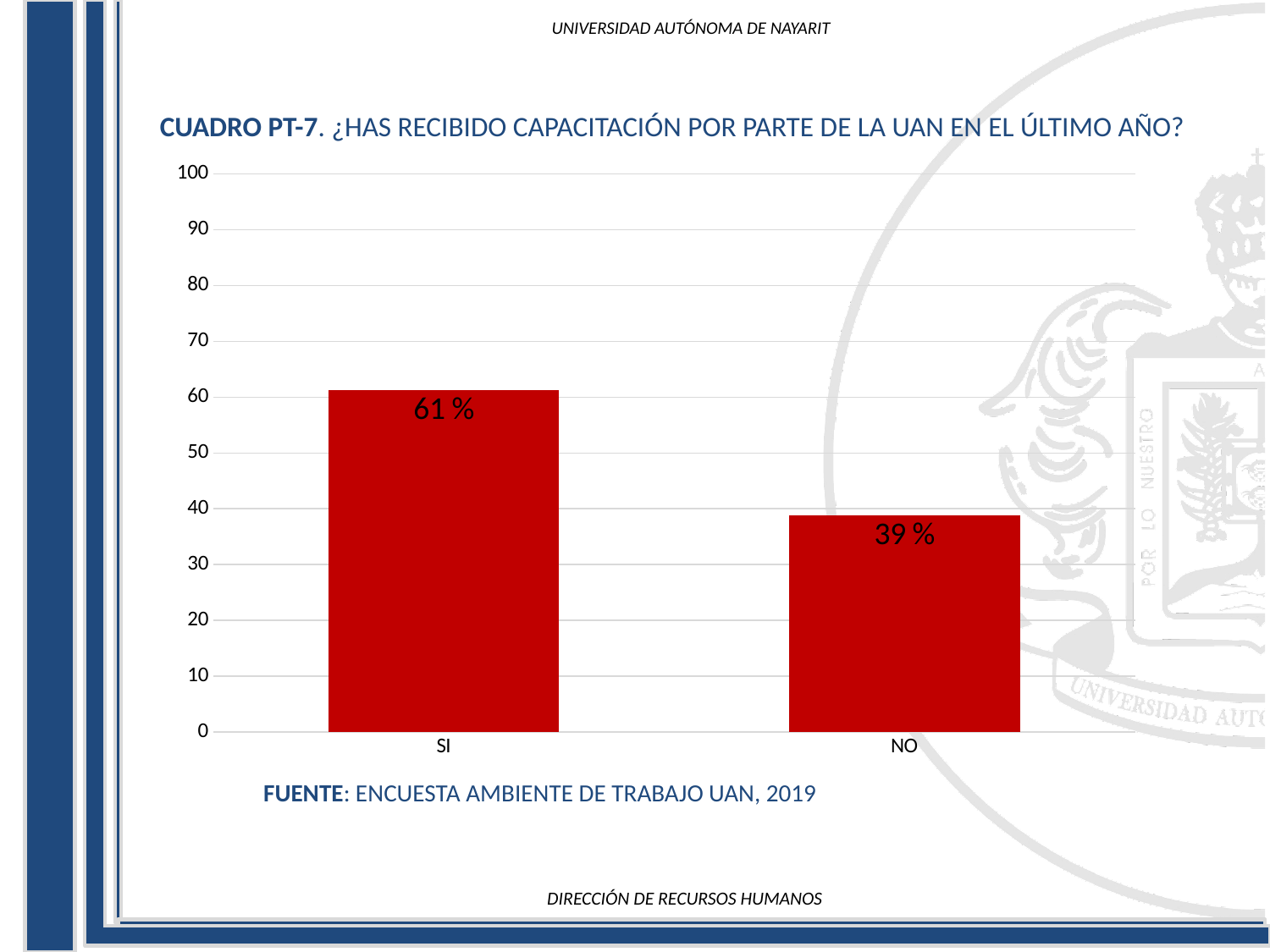
What is the value for SI? 61 % What is the source cited below the chart? ENCUESTA AMBIENTE DE TRABAJO UAN, 2019 Which category has the lowest value? NO What colour are the bars in the chart? red Is the value for NO greater or less than 50? less Is the value for SI greater or less than 50? greater What is the difference between the values for SI and NO? 22 % Which is larger, the value for SI or the value for NO? SI Which category has the highest value? SI What is the value for NO? 39 % What kind of chart is shown on the slide? bar chart How many categories are shown on the x axis? 2